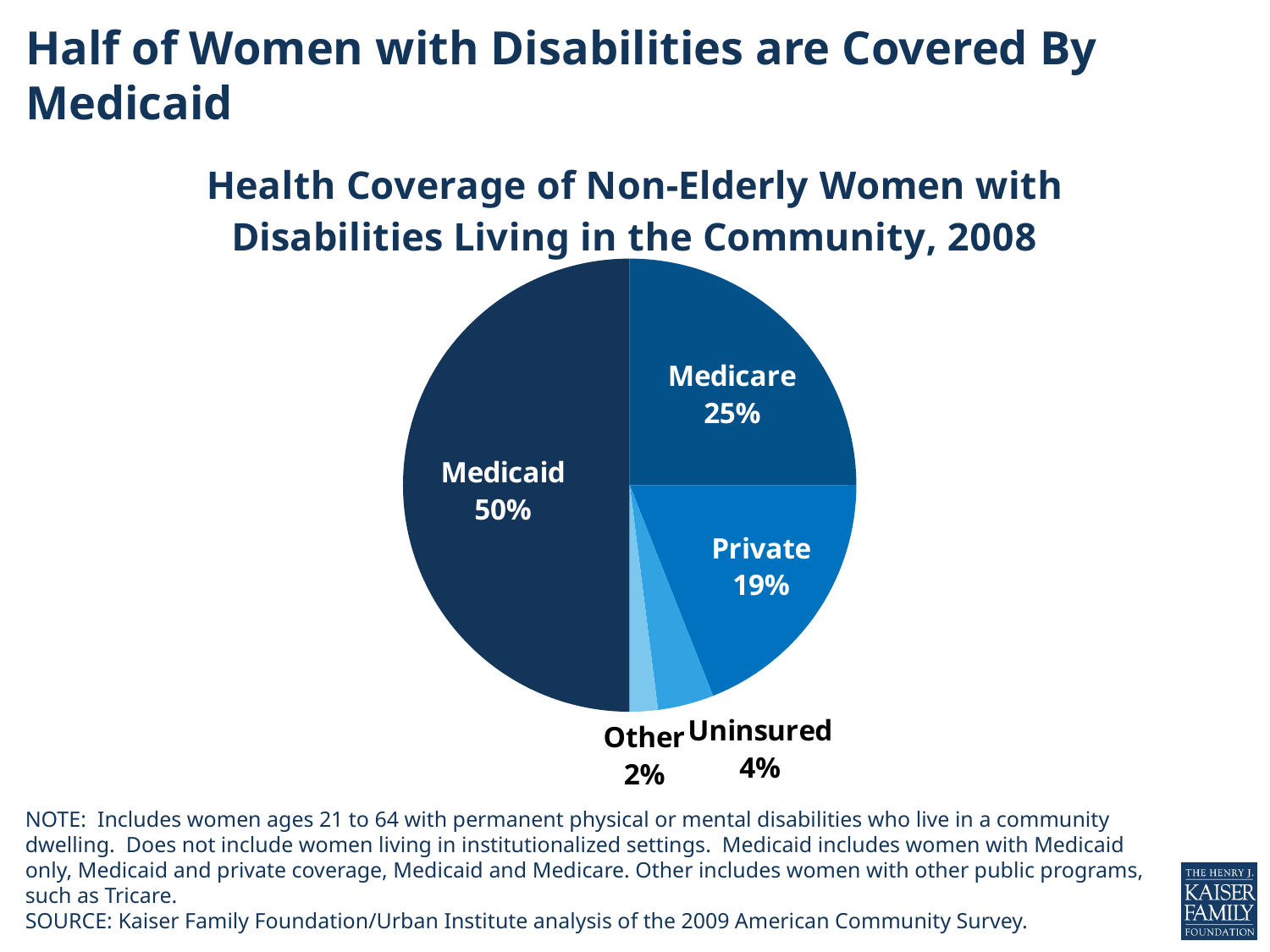
Which coverage category has the smallest share of the pie? Other What share of non-elderly women with disabilities are uninsured? 4% What share of non-elderly women with disabilities are covered by Medicare? 25% What share of non-elderly women with disabilities are covered by Medicaid? 50% Which coverage category has the largest share of the pie? Medicaid Which is larger, the Private share or the Uninsured share? Private What share of non-elderly women with disabilities have private coverage? 19% What share of non-elderly women with disabilities have other coverage? 2% What is the title of the chart? Health Coverage of Non-Elderly Women with Disabilities Living in the Community, 2008 What type of chart is shown on the slide? Pie chart How many percentage points larger is the Medicaid share than the Medicare share? 25 How many categories are shown in the pie chart? 5